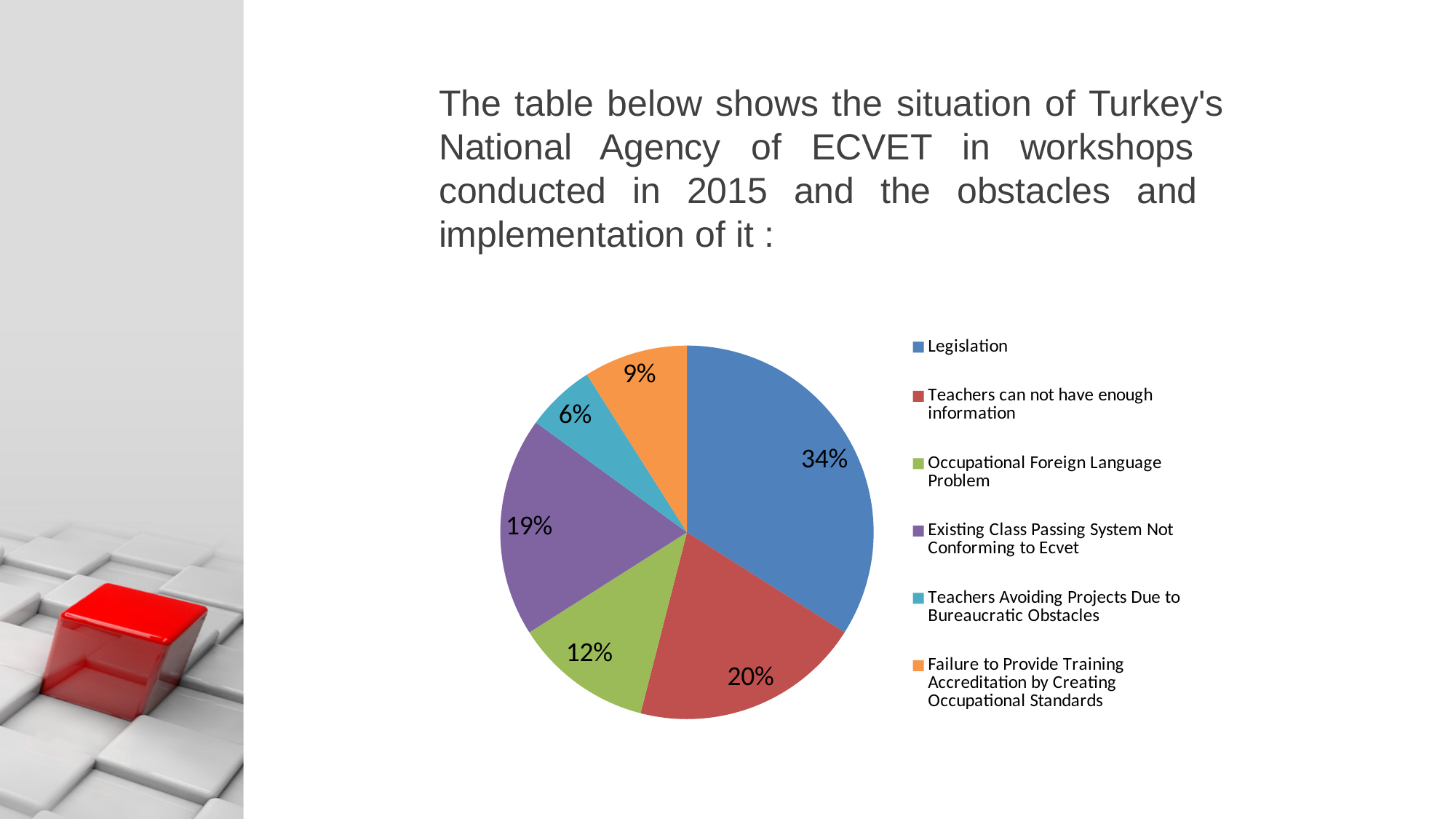
Which category has the largest slice of the pie? Legislation What percentage is shown for Failure to Provide Training Accreditation by Creating Occupational Standards? 9% What is the difference in percentage points between Legislation and Teachers can not have enough information? 14 What percentage is shown for Teachers can not have enough information? 20% What percentage is shown for Existing Class Passing System Not Conforming to Ecvet? 19% Which category has the smallest slice of the pie? Teachers Avoiding Projects Due to Bureaucratic Obstacles Which is larger: the slice for Occupational Foreign Language Problem or the slice for Existing Class Passing System Not Conforming to Ecvet? Existing Class Passing System Not Conforming to Ecvet What percentage is shown for Occupational Foreign Language Problem? 12% What kind of chart is shown on the slide? pie chart What share of the pie does Legislation have? 34% What percentage is shown for Teachers Avoiding Projects Due to Bureaucratic Obstacles? 6% How many categories does the legend list? 6